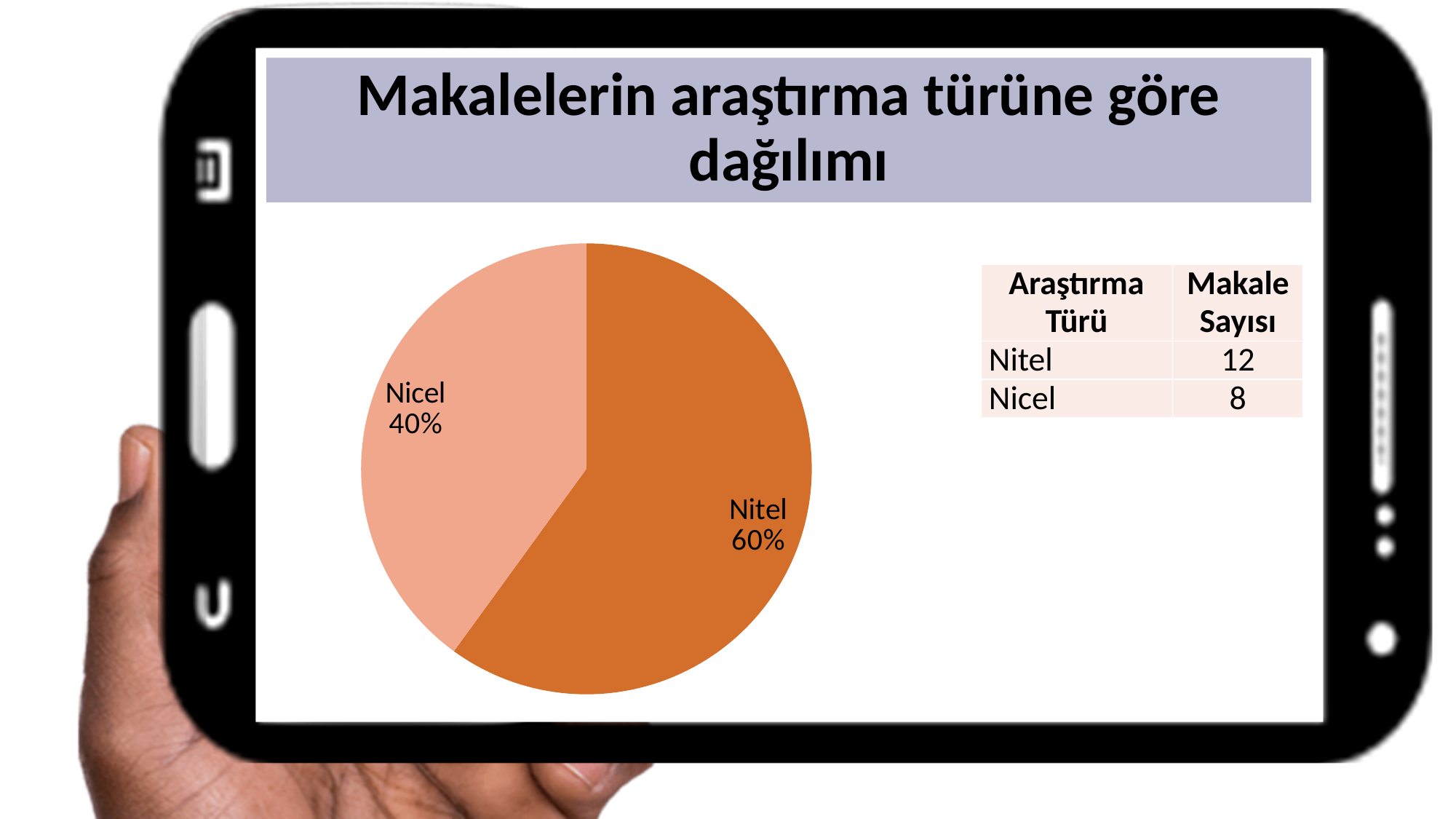
What is the title of the chart? Makalelerin araştırma türüne göre dağılımı How many slices does the pie chart have? 2 According to the table next to the chart, how many articles are Nitel? 12 Which category has the smallest slice of the pie? Nicel What is the difference in percentage points between the Nitel and Nicel slices? 20% According to the table next to the chart, how many articles are Nicel? 8 What share of the pie does the Nitel slice represent? 60% What is the total number of articles listed in the table next to the chart? 20 Which category has the largest slice of the pie? Nitel Which slice is larger, Nitel or Nicel? Nitel What kind of chart is shown on the slide? pie chart What share of the pie does the Nicel slice represent? 40%